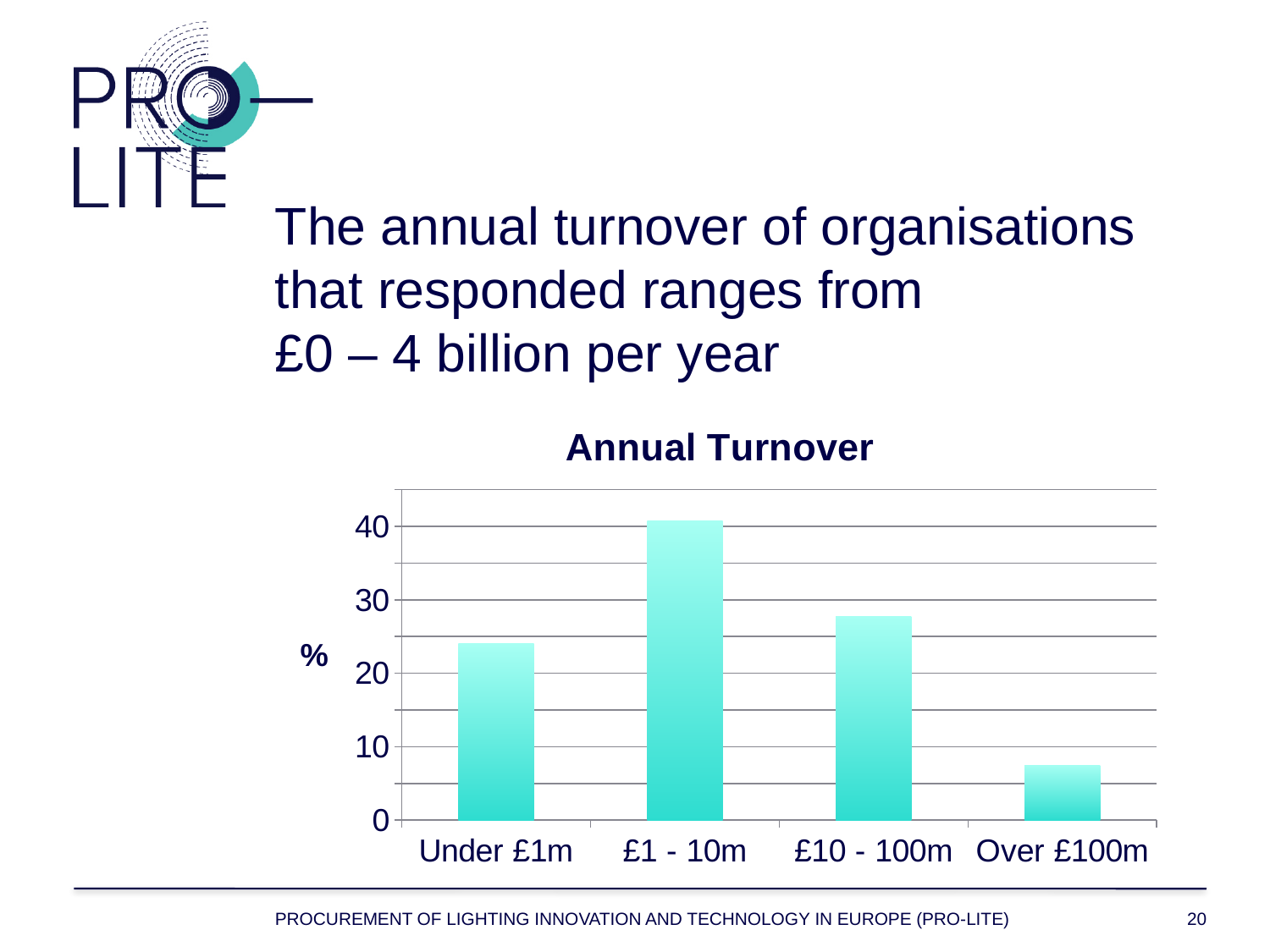
Which is larger, the value for £1 - 10m or the value for Over £100m? £1 - 10m How many turnover categories are shown on the x axis? 4 What type of chart is shown on the slide? bar chart Which turnover category has the lowest percentage? Over £100m Which is larger, the value for Under £1m or the value for £10 - 100m? £10 - 100m Is the value for £1 - 10m greater or less than 30? greater Is the value for £10 - 100m greater or less than 20? greater What is the title of the chart? Annual Turnover Is the value for Under £1m greater or less than 20? greater What label is shown on the vertical axis of the chart? % Which turnover category has the highest percentage? £1 - 10m